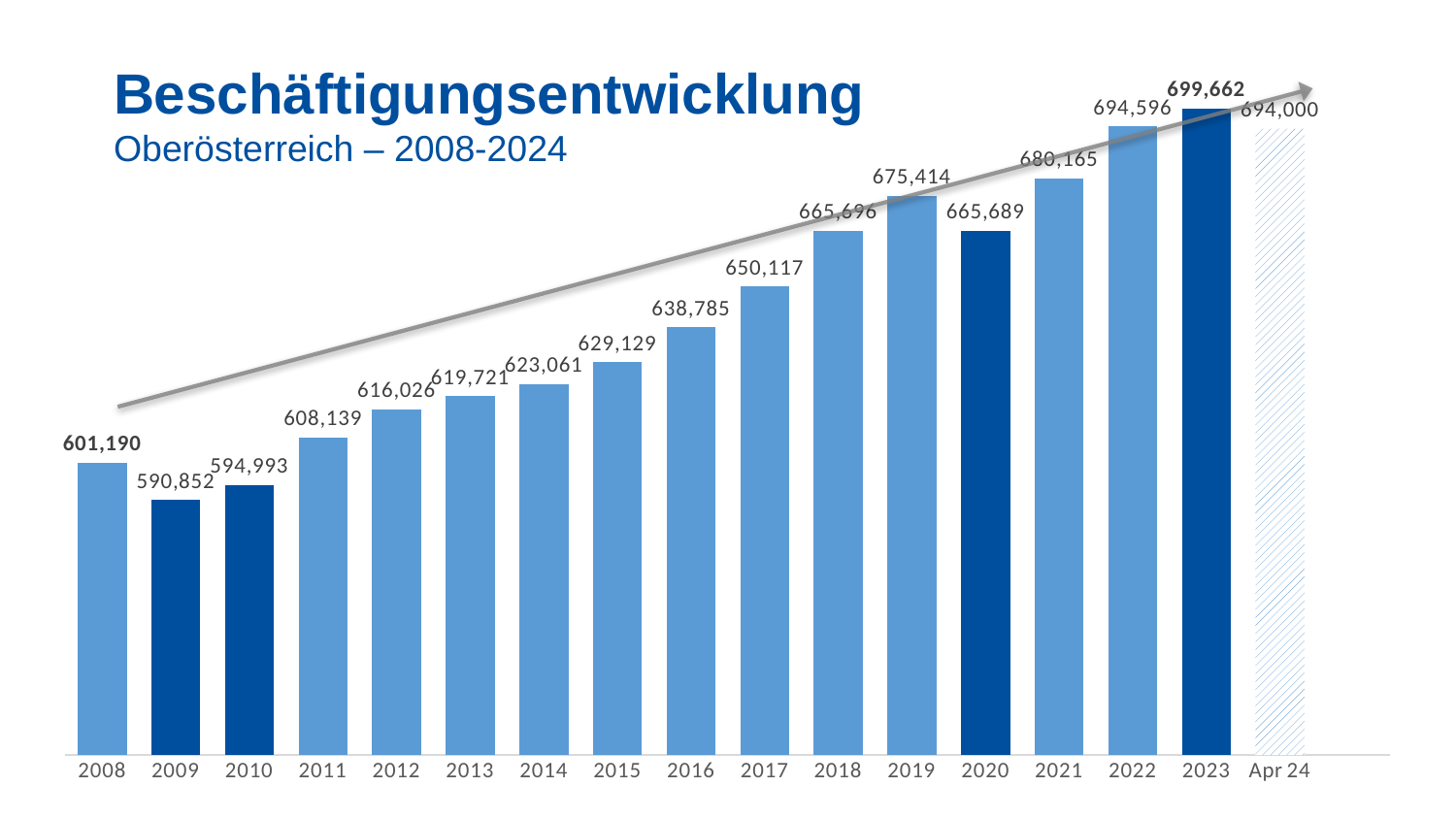
Which year has the lowest value? 2009 What is the title of the chart? Beschäftigungsentwicklung What is the value for 2016? 638,785 What is the value for 2020? 665,689 How many categories are shown on the x axis? 17 Which is larger, the value for 2019 or the value for 2020? 2019 Which year has the highest value? 2023 What is the value for 2008? 601,190 What is the difference between the values for 2022 and 2021? 14,431 What is the difference between the values for 2023 and 2008? 98,472 What kind of chart is shown on the slide? bar chart What is the value for Apr 24? 694,000